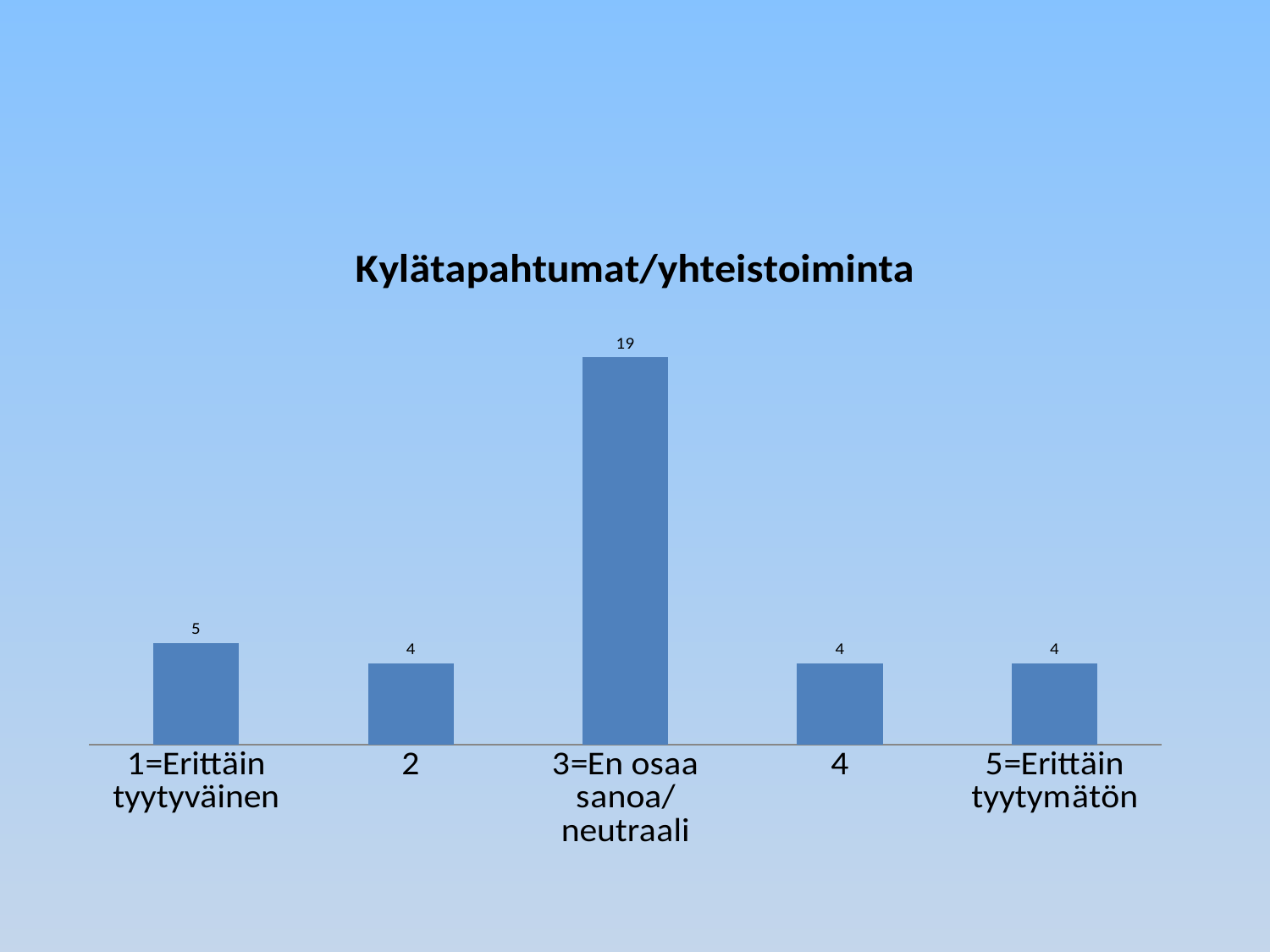
What is the total of all five values shown in the chart? 36 What is the title of the chart? Kylätapahtumat/yhteistoiminta Which category has the highest value? 3=En osaa sanoa/neutraali What is the value for the category "5=Erittäin tyytymätön"? 4 What is the value for the category "3=En osaa sanoa/neutraali"? 19 What is the value for category "2"? 4 What is the value for the category "1=Erittäin tyytyväinen"? 5 How many categories are shown on the x axis? 5 Which is larger, the value for "1=Erittäin tyytyväinen" or the value for "3=En osaa sanoa/neutraali"? 3=En osaa sanoa/neutraali What is the difference between the values for "3=En osaa sanoa/neutraali" and "1=Erittäin tyytyväinen"? 14 What kind of chart is shown on the slide? Bar chart What is the difference between the values for "1=Erittäin tyytyväinen" and "5=Erittäin tyytymätön"? 1